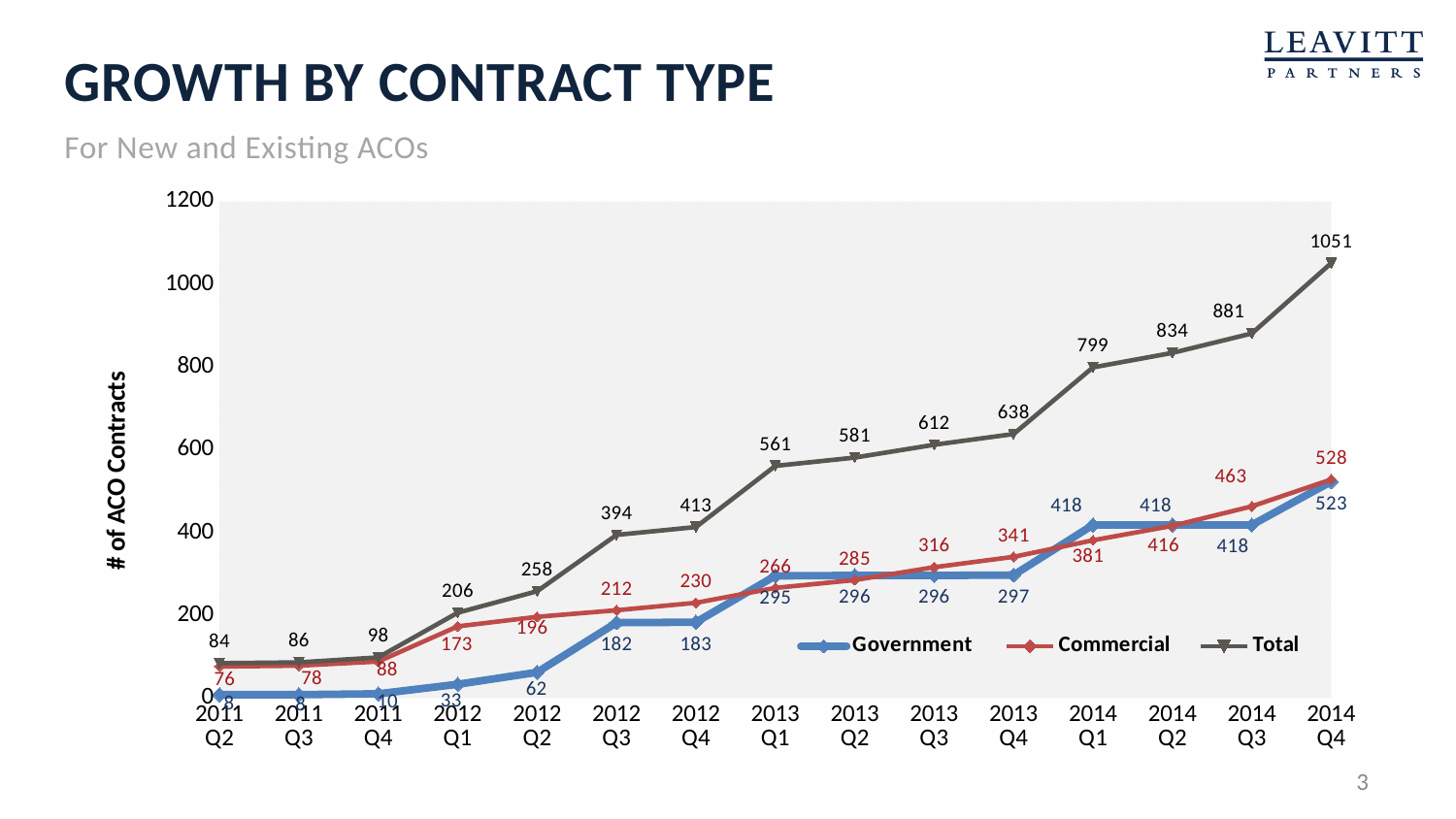
Does the Total series rise or fall from 2011 Q2 to 2014 Q4? Rise What is the Commercial value for 2013 Q3? 316 What is the difference between the Commercial and Government values in 2014 Q1? 37 What type of chart is shown on the slide? Line chart Which is larger in 2013 Q1, the Government value or the Commercial value? Government What is the label on the y axis? # of ACO Contracts In which quarter does the Government series reach its highest value? 2014 Q4 How many series does the legend list? 3 What is the Total value for 2014 Q4? 1051 What is the Government value for 2012 Q2? 62 In which quarter is the Total value lowest? 2011 Q2 How many quarters are plotted along the x axis? 15